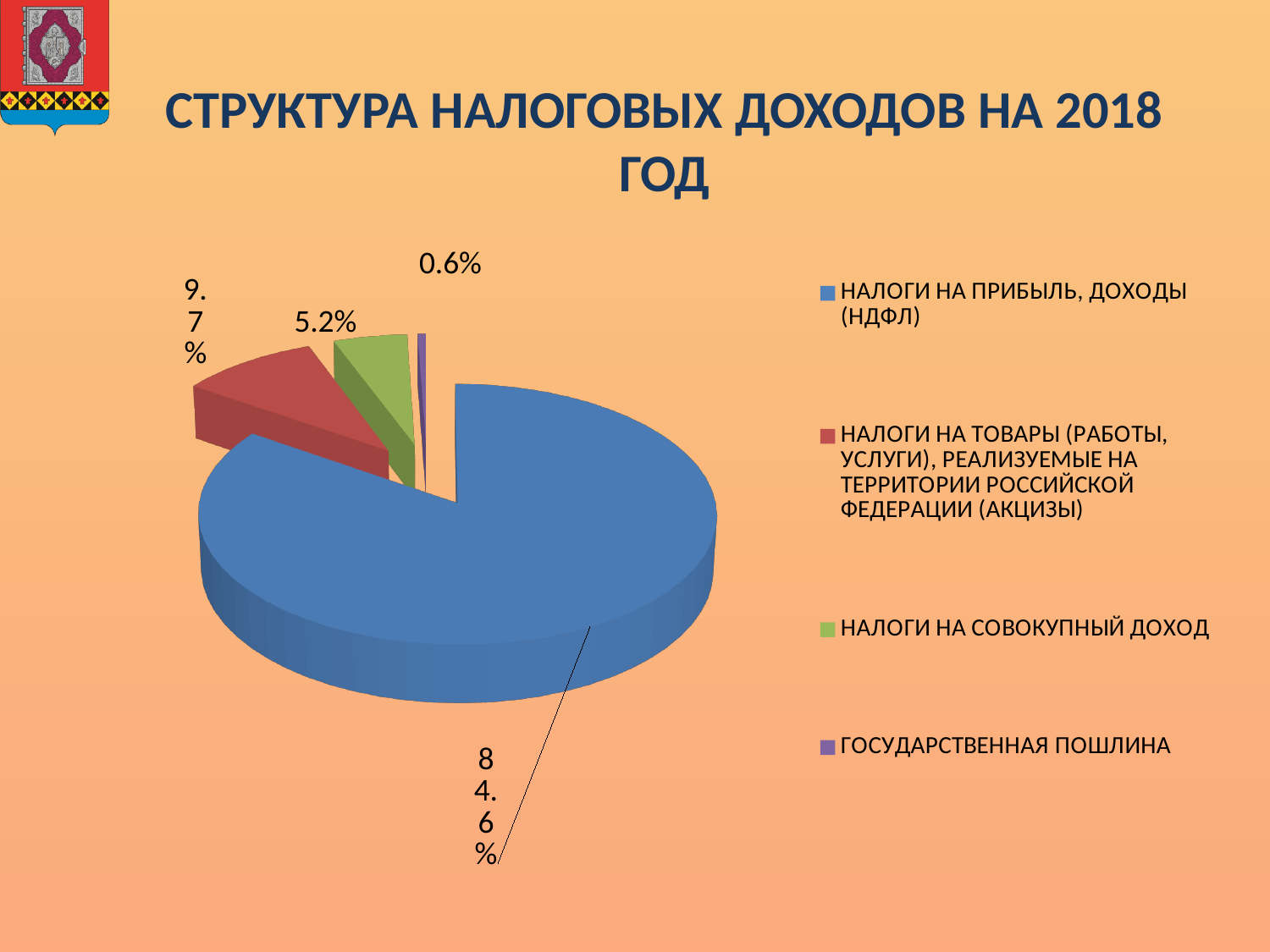
What share of tax revenues does НАЛОГИ НА ПРИБЫЛЬ, ДОХОДЫ (НДФЛ) account for? 84.6% Which category has the smallest share of the pie? ГОСУДАРСТВЕННАЯ ПОШЛИНА Which is larger: the share for НАЛОГИ НА СОВОКУПНЫЙ ДОХОД or the share for ГОСУДАРСТВЕННАЯ ПОШЛИНА? НАЛОГИ НА СОВОКУПНЫЙ ДОХОД How many categories does the pie chart show? 4 Which category has the largest share of the pie? НАЛОГИ НА ПРИБЫЛЬ, ДОХОДЫ (НДФЛ) What is the title of the slide? СТРУКТУРА НАЛОГОВЫХ ДОХОДОВ НА 2018 ГОД What share is shown for ГОСУДАРСТВЕННАЯ ПОШЛИНА? 0.6% What share is shown for НАЛОГИ НА СОВОКУПНЫЙ ДОХОД? 5.2% What is the difference in percentage points between the share for АКЦИЗЫ and the share for НАЛОГИ НА СОВОКУПНЫЙ ДОХОД? 4.5 What colour is the slice for НАЛОГИ НА СОВОКУПНЫЙ ДОХОД? Green What kind of chart is shown on the slide? Pie chart What share is shown for НАЛОГИ НА ТОВАРЫ (РАБОТЫ, УСЛУГИ), РЕАЛИЗУЕМЫЕ НА ТЕРРИТОРИИ РОССИЙСКОЙ ФЕДЕРАЦИИ (АКЦИЗЫ)? 9.7%